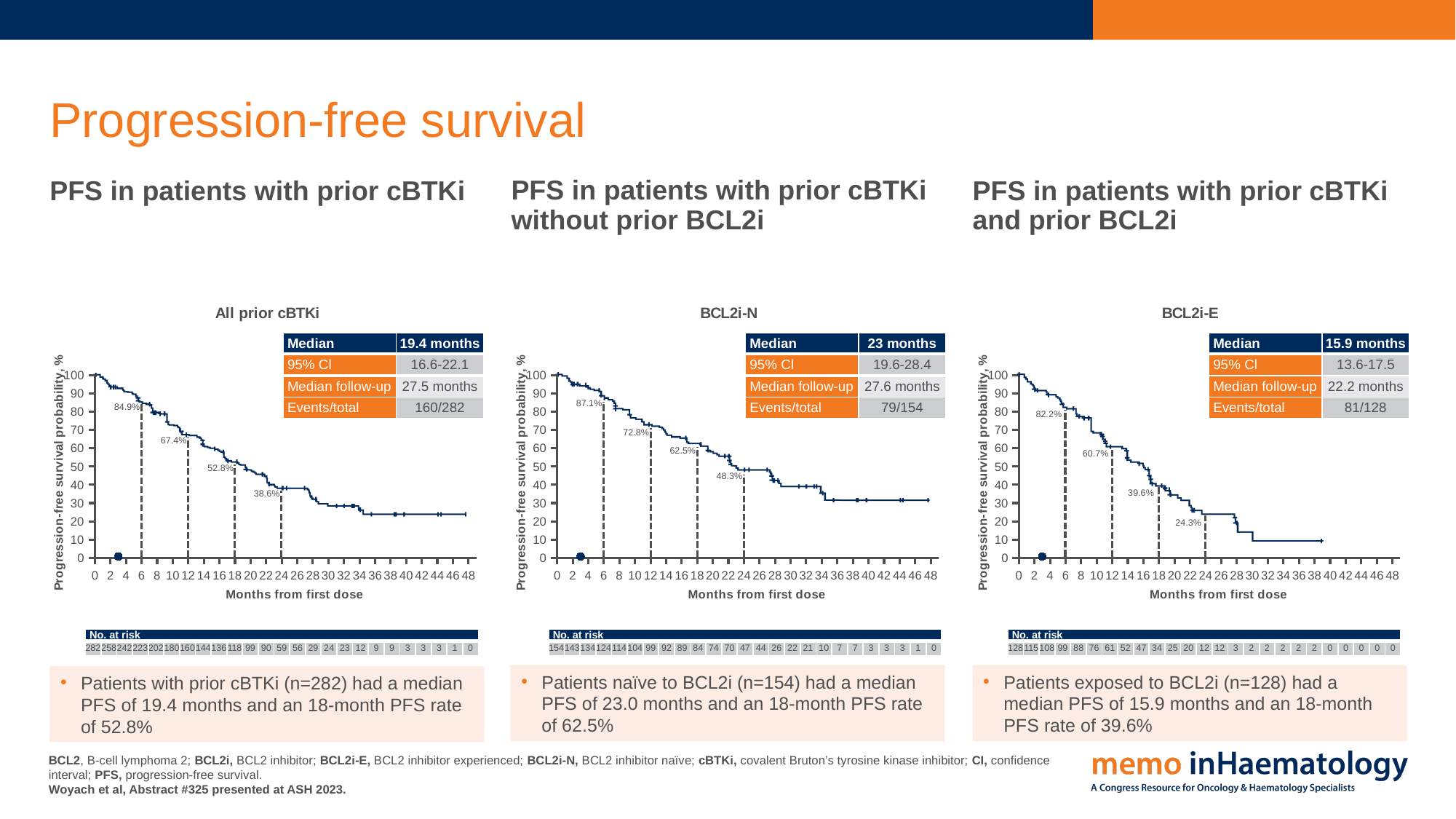
Among the three charts, which has the lowest labelled PFS rate at 24 months? BCL2i-E Which chart shows the higher 18-month PFS rate, BCL2i-N or BCL2i-E? BCL2i-N In the BCL2i-E chart, what is the Events/total value shown in the table? 81/128 In the All prior cBTKi chart, what is the progression-free survival probability labelled at 12 months? 67.4% In the BCL2i-E chart, does the progression-free survival probability rise or fall as months from first dose increase? fall In the BCL2i-E chart, what is the progression-free survival probability labelled at 6 months? 82.2% What is the difference between the 18-month PFS rate in the BCL2i-N chart and the 18-month PFS rate in the BCL2i-E chart? 22.9 percentage points In the All prior cBTKi chart, what is the difference between the labelled PFS rate at 6 months and at 24 months? 46.3 percentage points In the All prior cBTKi chart, what median PFS is shown in the table? 19.4 months In the BCL2i-N chart, what is the progression-free survival probability labelled at 24 months? 48.3% In the All prior cBTKi chart, is the progression-free survival probability at 36 months greater or less than 30? less What kind of chart is the BCL2i-N chart? line chart